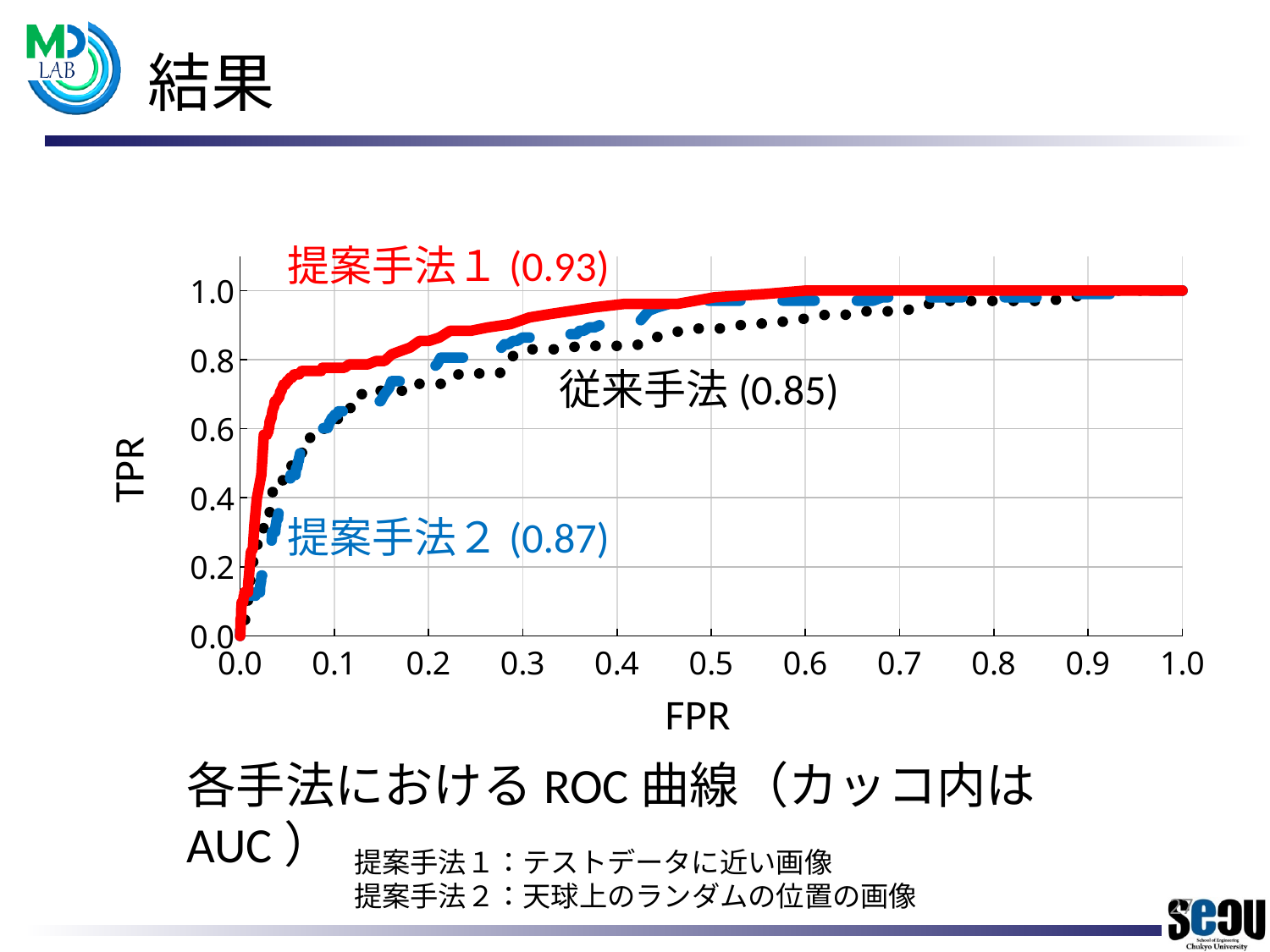
Which method has the lowest AUC? 従来手法 What kind of chart is shown on the slide? Line chart Which method has the highest AUC? 提案手法1 What is the difference between the AUC of 提案手法1 and the AUC of 従来手法? 0.08 What AUC value is shown for 従来手法? 0.85 What is the difference between the AUC of 提案手法2 and the AUC of 従来手法? 0.02 What AUC value is shown for 提案手法1? 0.93 What are the labels of the x axis and y axis of the chart? FPR and TPR Which has a larger AUC, 提案手法2 or 従来手法? 提案手法2 What AUC value is shown for 提案手法2? 0.87 How many ROC curves are plotted on the chart? 3 Is the TPR of 提案手法1 at FPR 0.1 greater or less than 0.6? greater